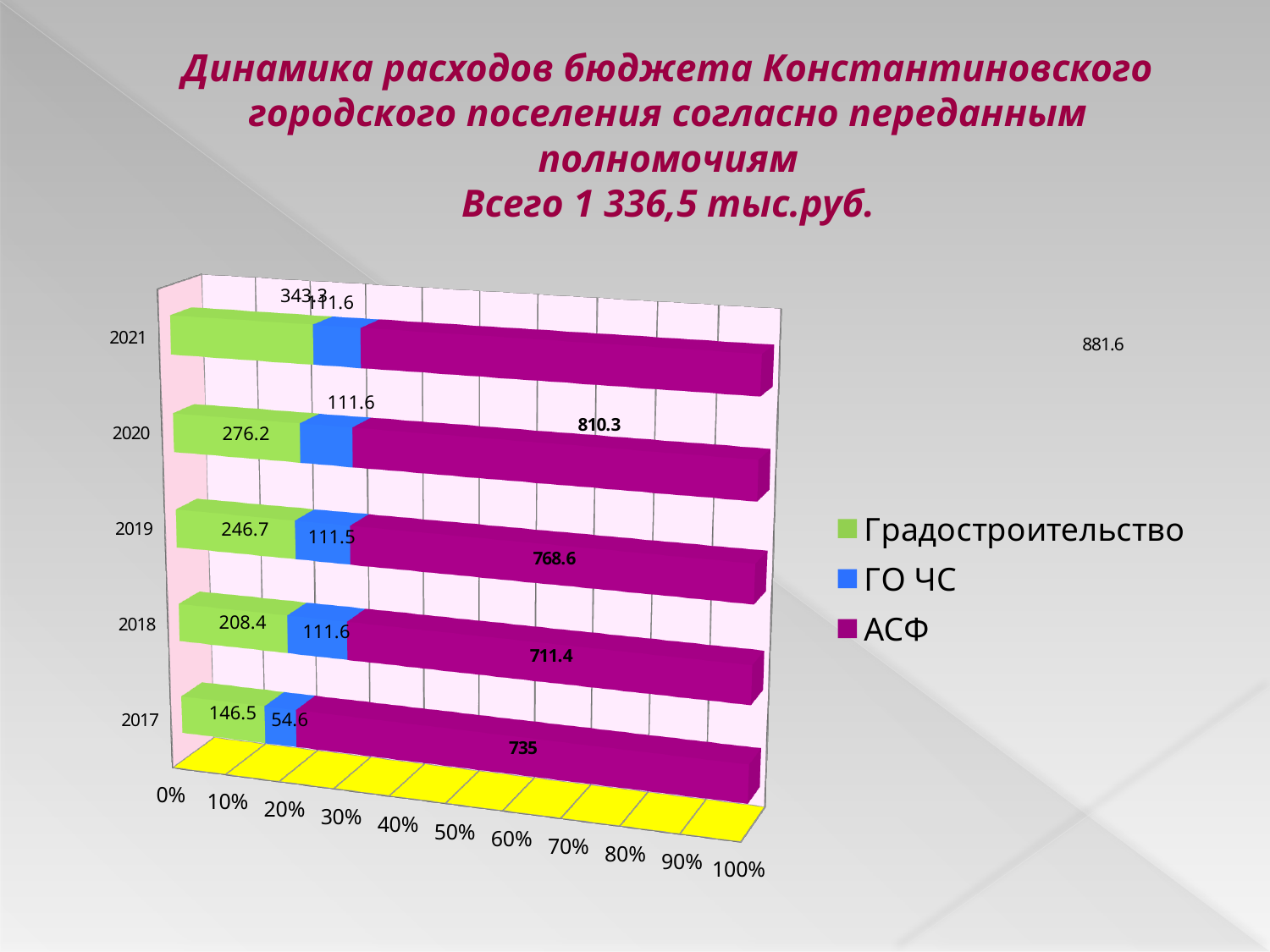
In which year is the value for ГО ЧС the lowest? 2017 What type of chart is shown on the slide? bar chart In which year is the value for Градостроительство the highest? 2021 What is the value for Градостроительство in 2021? 343.3 What is the difference between the АСФ values for 2021 and 2020? 71.3 How many years (categories) are shown on the chart? 5 Which is larger: the АСФ value for 2017 or for 2018? 2017 Does the value for Градостроительство rise or fall from 2017 to 2021? rise What is the total of the three values for 2017? 936.1 How many series does the legend list? 3 What is the value for ГО ЧС in 2017? 54.6 What is the value for АСФ in 2019? 768.6